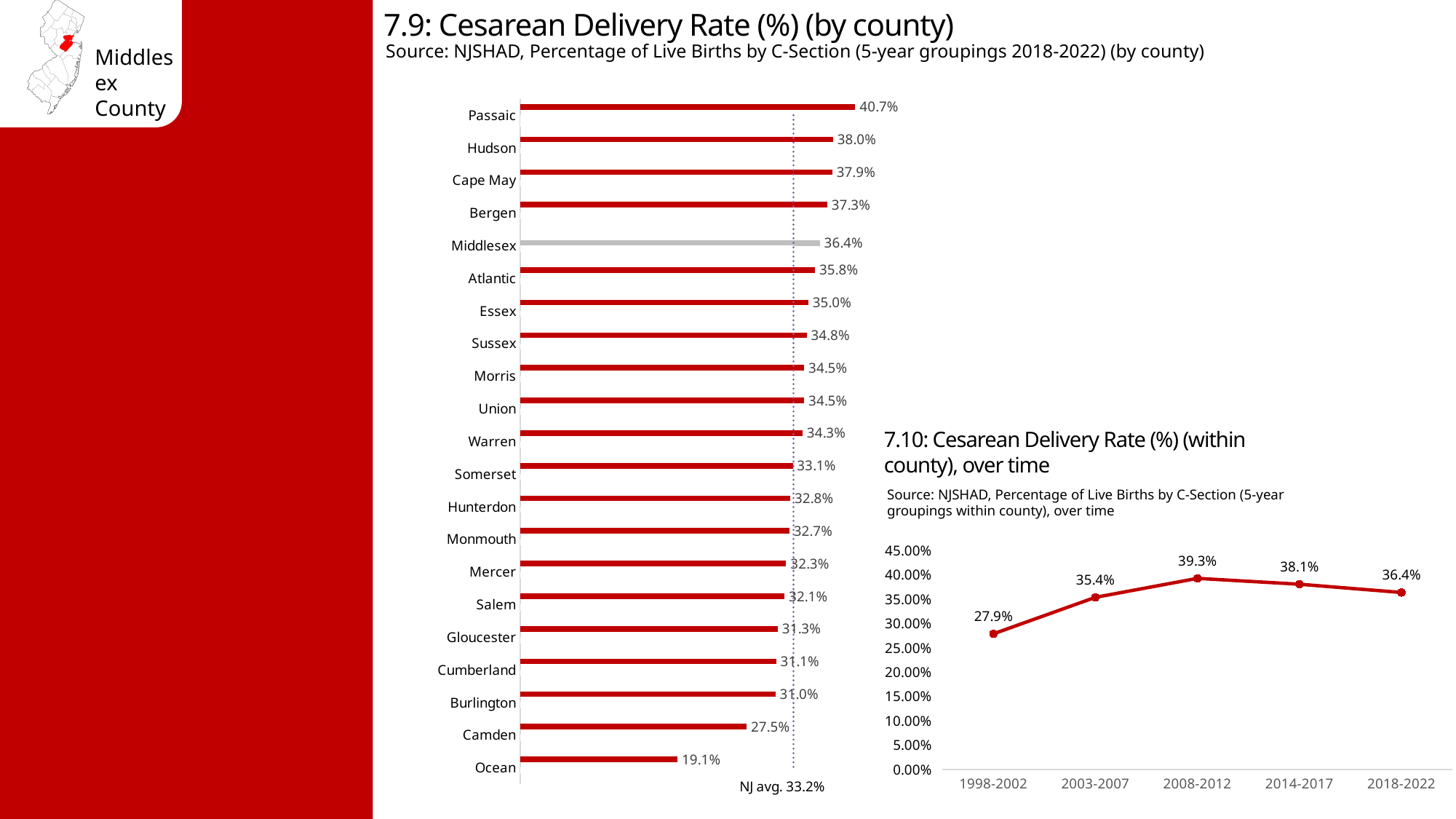
In the 7.10 Cesarean Delivery Rate over time chart, what is the difference between 2008-2012 and 2018-2022? 2.9% In the 7.9 Cesarean Delivery Rate (by county) chart, what is the value for Middlesex? 36.4% In the 7.9 Cesarean Delivery Rate (by county) chart, which county has the lowest rate? Ocean In the 7.9 Cesarean Delivery Rate (by county) chart, which is larger, Hudson or Bergen? Hudson In the 7.10 Cesarean Delivery Rate over time chart, which period has the lowest value? 1998-2002 In the 7.9 Cesarean Delivery Rate (by county) chart, how many counties are shown? 21 In the 7.9 Cesarean Delivery Rate (by county) chart, which county has the highest rate? Passaic In the 7.10 Cesarean Delivery Rate over time chart, how many time periods are plotted? 5 What kind of chart is the 7.10 Cesarean Delivery Rate (within county), over time chart? line chart In the 7.10 Cesarean Delivery Rate over time chart, what is the value for 2008-2012? 39.3% In the 7.9 Cesarean Delivery Rate (by county) chart, what is the NJ average shown by the dotted line? 33.2% In the 7.9 Cesarean Delivery Rate (by county) chart, what is the difference between Passaic and Ocean? 21.6%